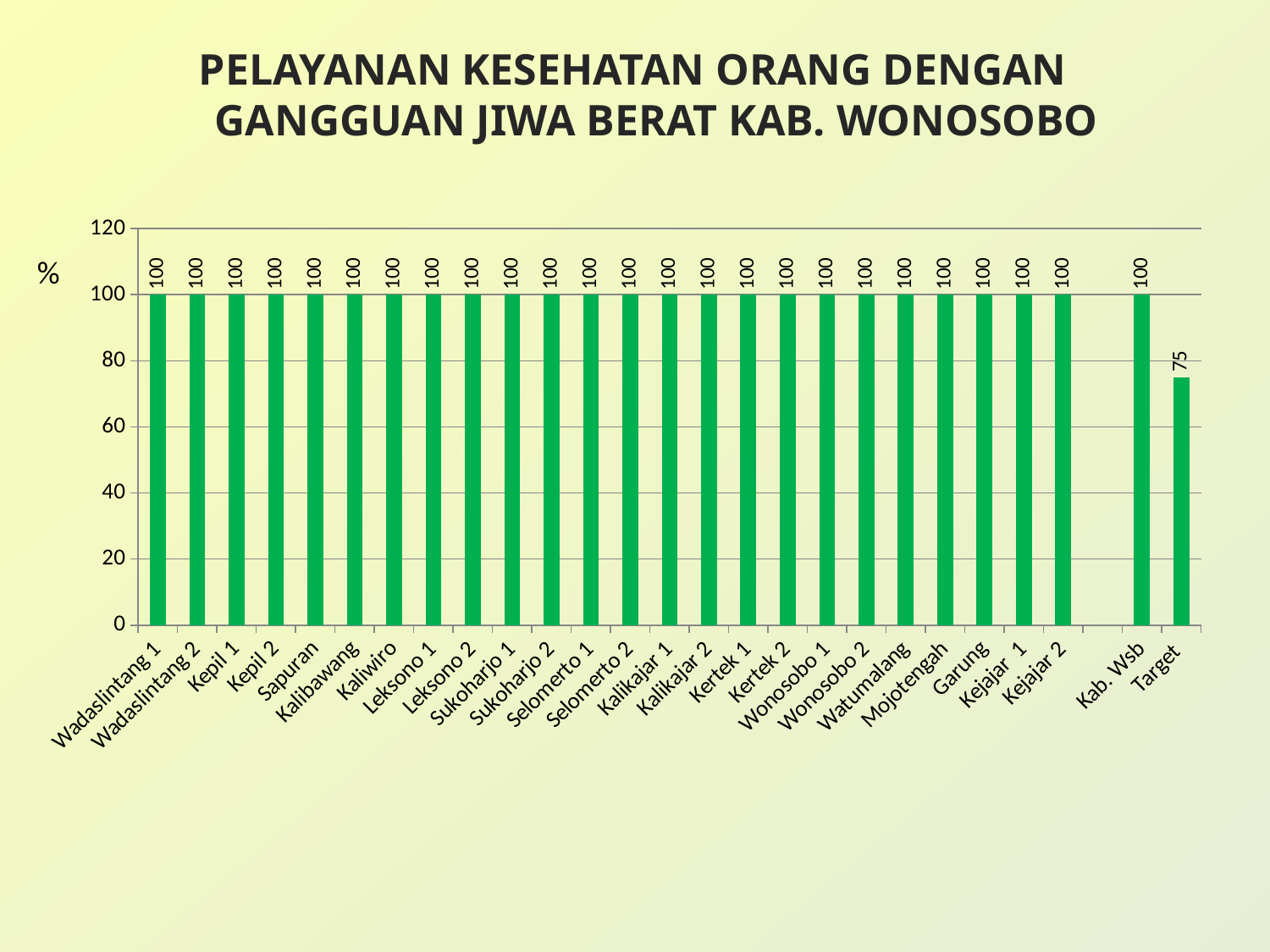
What is the value for Kejajar 2? 100 What colour are the bars in the chart? green What is the value for Wadaslintang 1? 100 What kind of chart is shown on the slide? bar chart Is the value for Target greater or less than 80? less Which category has the lowest value? Target What is the value for Target? 75 How many bars are plotted on the chart? 26 Which is larger, the value for Garung or the value for Target? Garung What is the value for Kab. Wsb? 100 What is the difference between the value for Kab. Wsb and the value for Target? 25 What is the label on the vertical axis? %